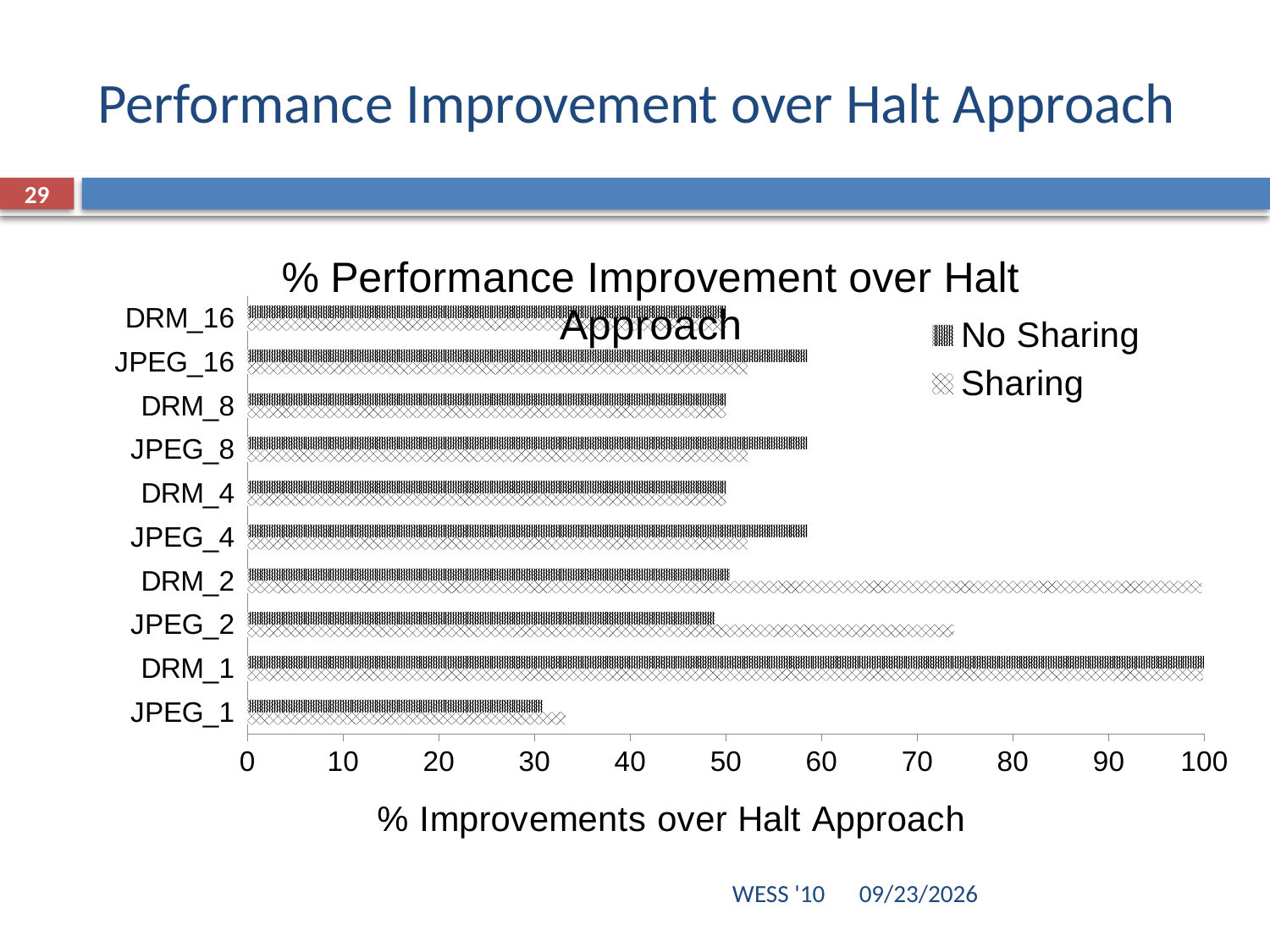
How many categories are plotted on the y axis? 10 For DRM_2, which is larger: the Sharing value or the No Sharing value? Sharing Is the No Sharing value for JPEG_1 greater or less than 40? less Is the Sharing value for DRM_2 greater or less than 90? greater How many series does the legend list? 2 What kind of chart is shown on the slide? bar chart What is the title of the x axis? % Improvements over Halt Approach For JPEG_2, which is larger: the Sharing value or the No Sharing value? Sharing Is the No Sharing value for JPEG_4 greater or less than 50? greater What are the two entries in the legend? No Sharing and Sharing Which category has the lowest No Sharing value? JPEG_1